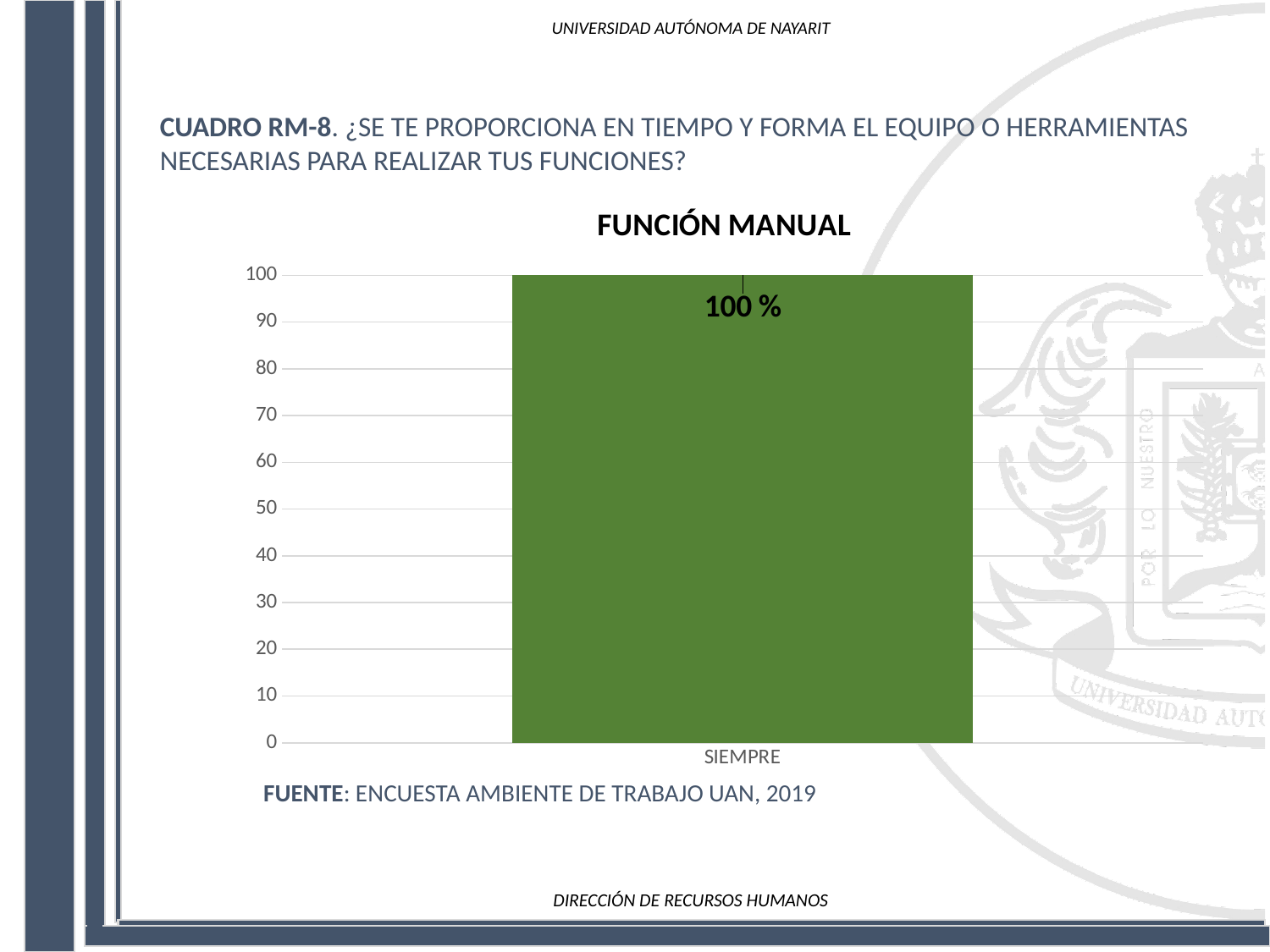
What is the label of the only category on the x axis? SIEMPRE What is the title of the chart? FUNCIÓN MANUAL What is the value for SIEMPRE? 100 % Is the value for SIEMPRE greater or less than 50? greater What is the highest value shown on the y axis? 100 How many categories are shown on the x axis? 1 What kind of chart is this? bar chart